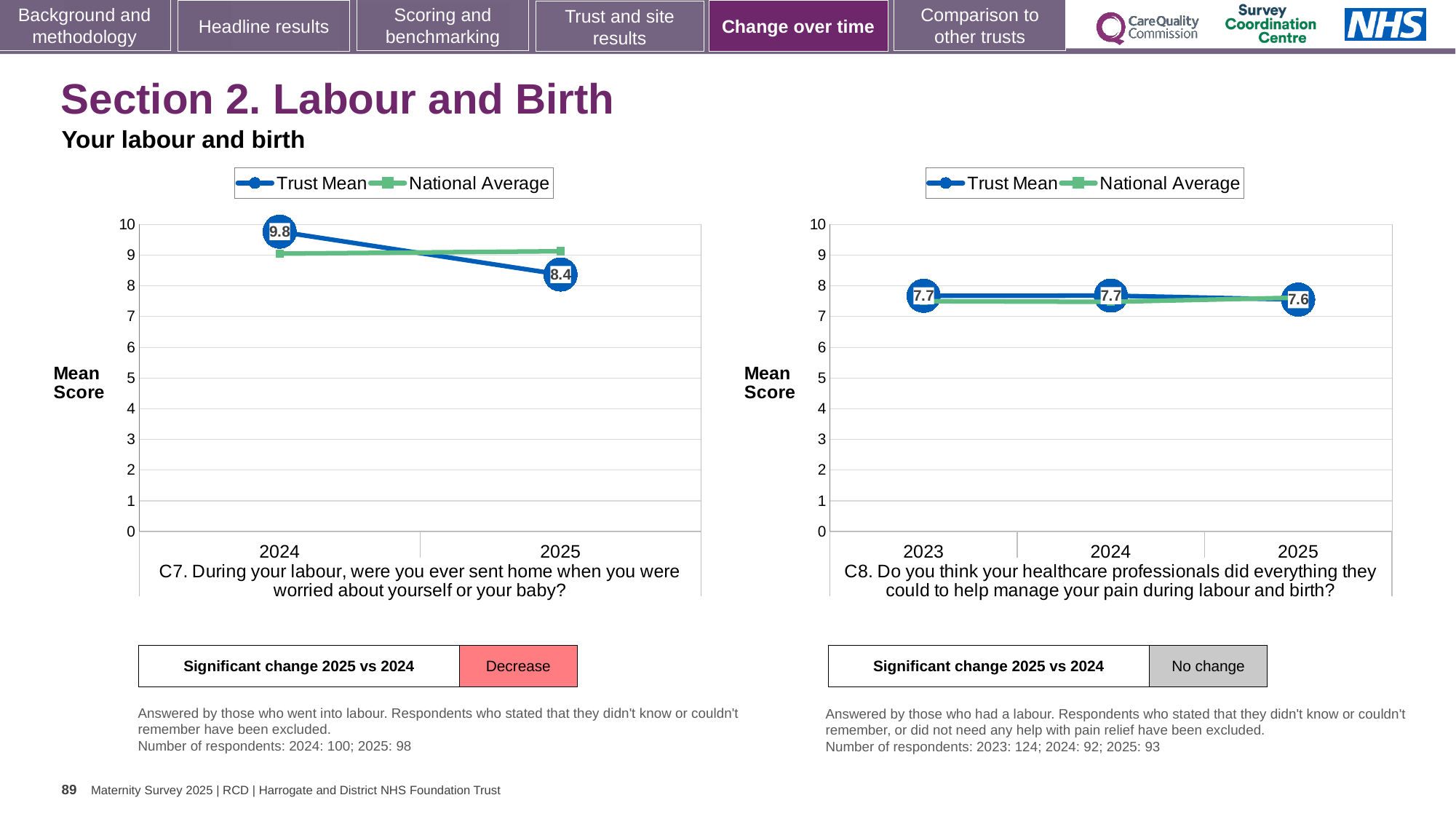
How many series does the legend of the left chart (C7) list? 2 In the right chart (C8), what is the Trust Mean score for 2025? 7.6 In the left chart (C7), is the National Average for 2024 greater or less than 8? greater How many years are plotted on the x axis of the right chart (C8)? 3 In the left chart (C7), what is the Trust Mean score for 2025? 8.4 In the right chart (C8), is the National Average for 2023 greater or less than 7? greater In the left chart (C7), is the Trust Mean for 2024 larger or smaller than the National Average for 2024? larger In the right chart (C8), what is the Trust Mean score for 2023? 7.7 In the left chart (C7), what is the Trust Mean score for 2024? 9.8 In the left chart (C7), does the Trust Mean rise or fall from 2024 to 2025? fall What type of chart is used for the C8 question on the right? line chart In the left chart (C7), by how much did the Trust Mean fall from 2024 to 2025? 1.4